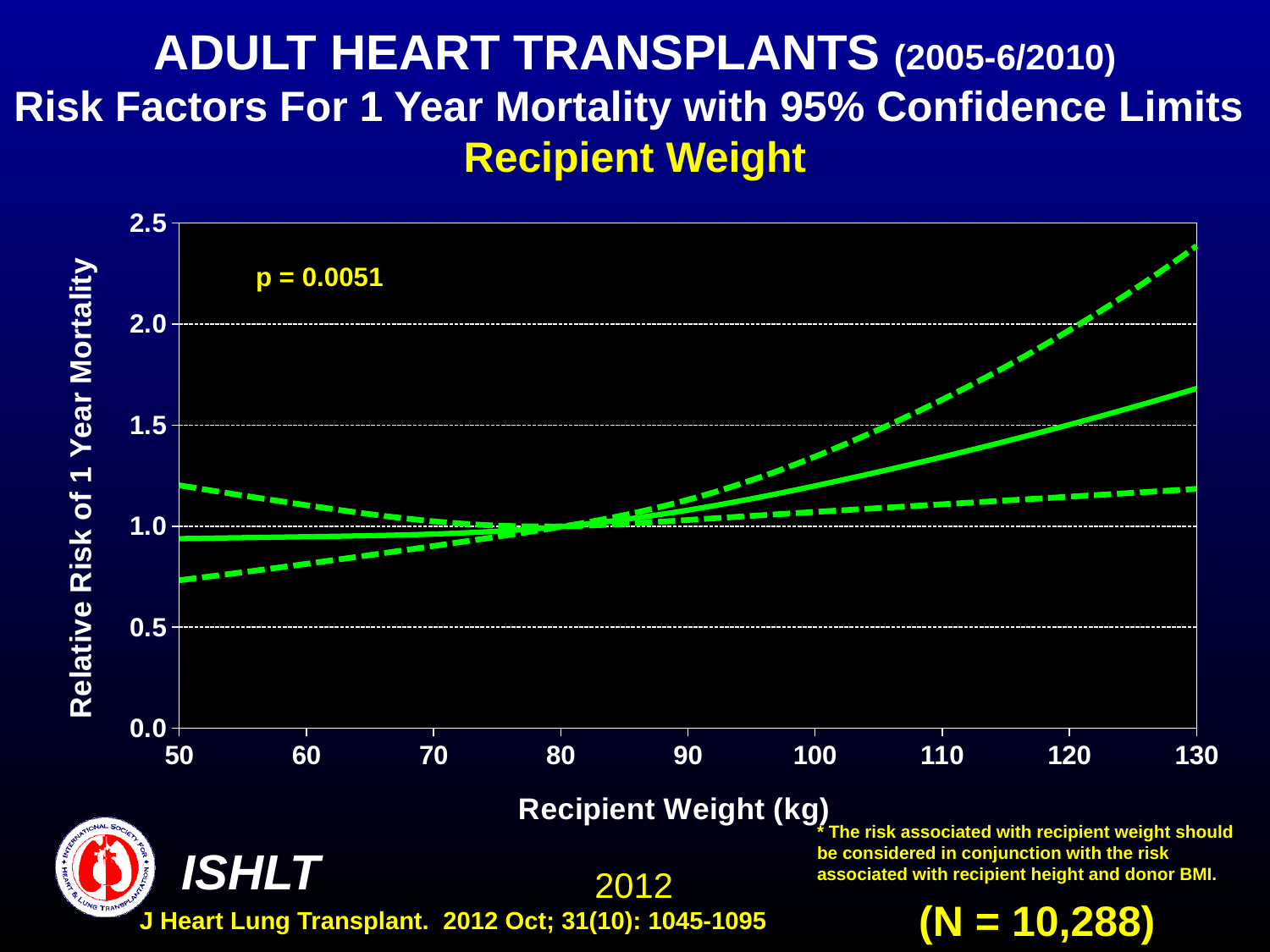
Does the solid line for relative risk of 1 year mortality rise or fall as recipient weight increases from 50 kg to 130 kg? rise Is the lower 95% confidence limit (lower dashed line) at a recipient weight of 130 kg greater or less than 1.0? greater Is the lower 95% confidence limit (lower dashed line) at a recipient weight of 50 kg greater or less than 1.0? less What is the label of the x axis? Recipient Weight (kg) What is the highest value shown on the y axis? 2.5 Is the relative risk shown by the solid line at a recipient weight of 130 kg greater or less than 1.5? greater How many lines are plotted on the chart? 3 What is the sample size N printed on the slide? N = 10,288 What is the p-value printed on the chart? p = 0.0051 What kind of chart is shown on the slide? line chart